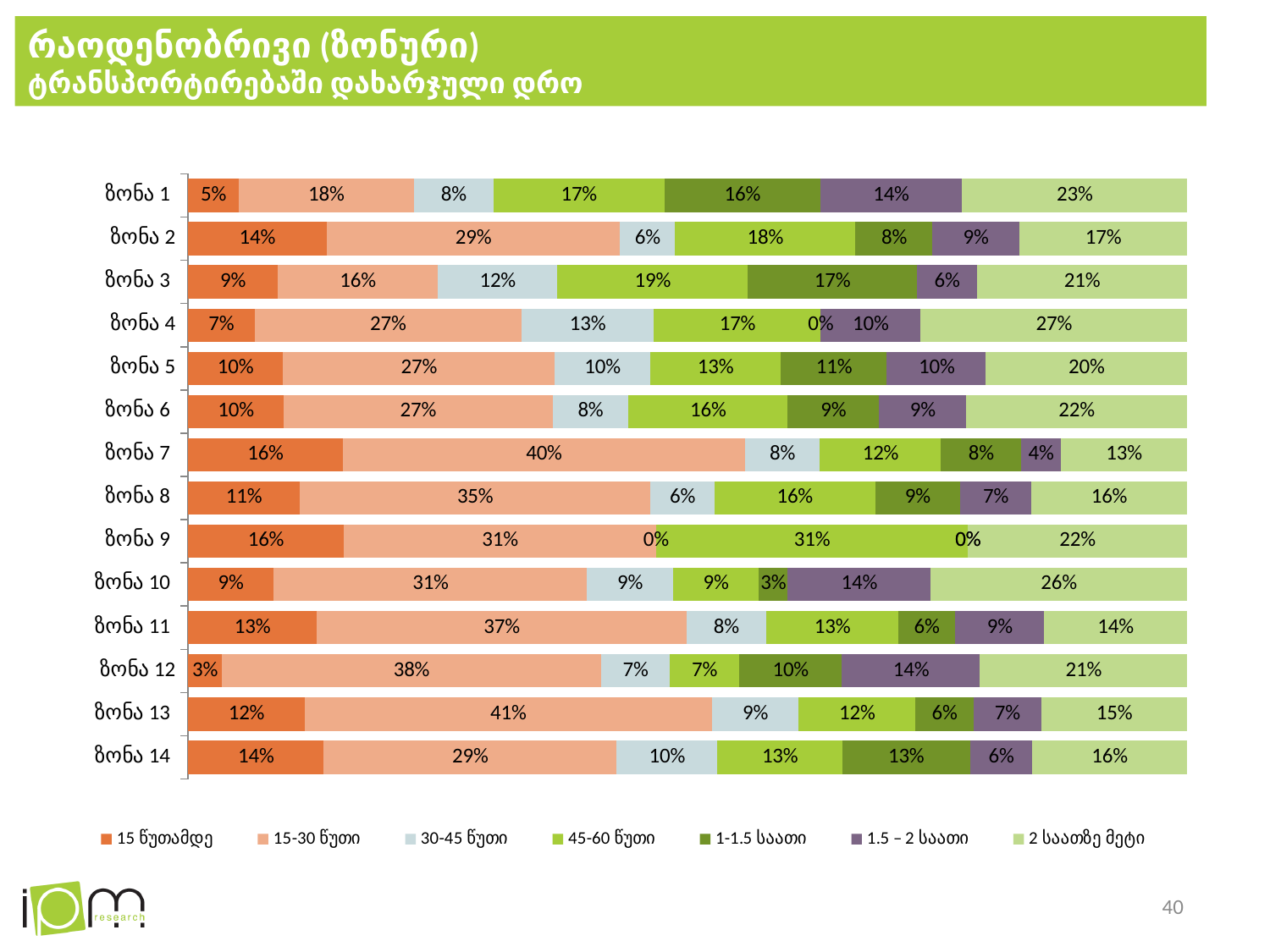
Which zone has the lowest value for 15 წუთამდე? ზონა 12 Which zone has the highest value for 15-30 წუთი? ზონა 13 Which legend entry is shown in the darkest green colour? 1-1.5 საათი How many zones are shown in the chart? 14 What is the value for 1.5 – 2 საათი in ზონა 10? 14% What is the value for 2 საათზე მეტი in ზონა 4? 27% What is the difference between the 15-30 წუთი values of ზონა 7 and ზონა 2? 11% What is the value for 1-1.5 საათი in ზონა 14? 13% How many series does the legend list? 7 Which is larger: the 2 საათზე მეტი value for ზონა 1 or for ზონა 7? ზონა 1 What share of ზონა 1 falls in the 15-30 წუთი category? 18% What kind of chart is shown on the slide? Stacked bar chart